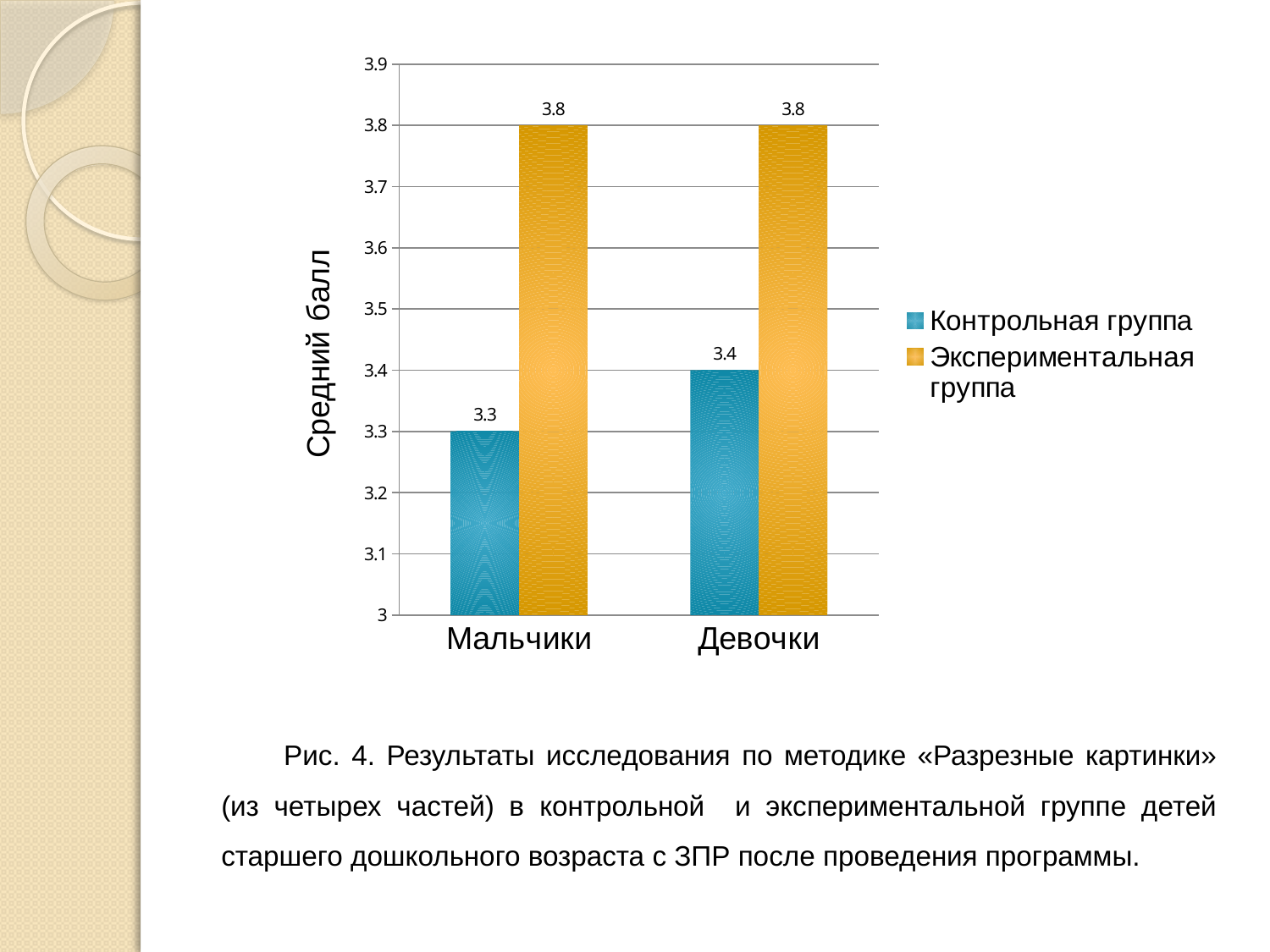
How many series does the legend list? 2 Which is larger for Девочки: Контрольная группа or Экспериментальная группа? Экспериментальная группа What is the value for Контрольная группа for Мальчики? 3.3 What kind of chart is shown on the slide? Bar chart What is the value for Экспериментальная группа for Мальчики? 3.8 Which category has the lowest value for Контрольная группа? Мальчики What is the difference between Экспериментальная группа and Контрольная группа for Мальчики? 0.5 What is the value for Контрольная группа for Девочки? 3.4 What is the difference between Экспериментальная группа and Контрольная группа for Девочки? 0.4 How many categories are shown on the x axis? 2 What is the label of the vertical axis? Средний балл What is the value for Экспериментальная группа for Девочки? 3.8